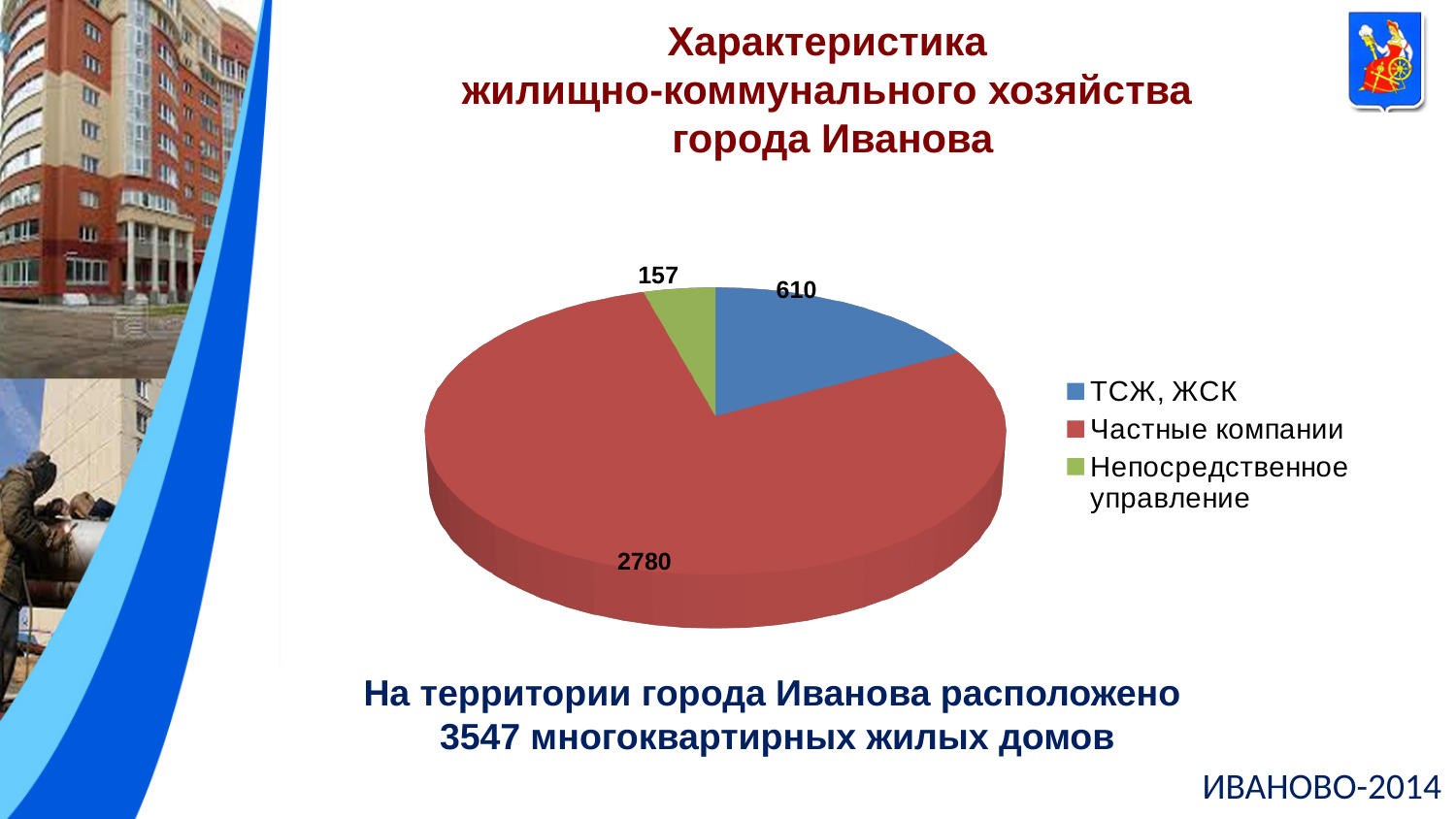
How many categories does the pie chart have? 3 What is the difference between the values for Частные компании and ТСЖ, ЖСК? 2170 Which category has the largest slice of the pie? Частные компании What kind of chart is shown on the slide? Pie chart Which category has the smallest slice of the pie? Непосредственное управление What is the difference between the values for ТСЖ, ЖСК and Непосредственное управление? 453 What is the value for Частные компании? 2780 Which is larger, the value for ТСЖ, ЖСК or the value for Непосредственное управление? ТСЖ, ЖСК What is the value for Непосредственное управление? 157 What is the total of all three slices of the pie chart? 3547 What is the value for ТСЖ, ЖСК? 610 What colour is the slice for Частные компании? Red